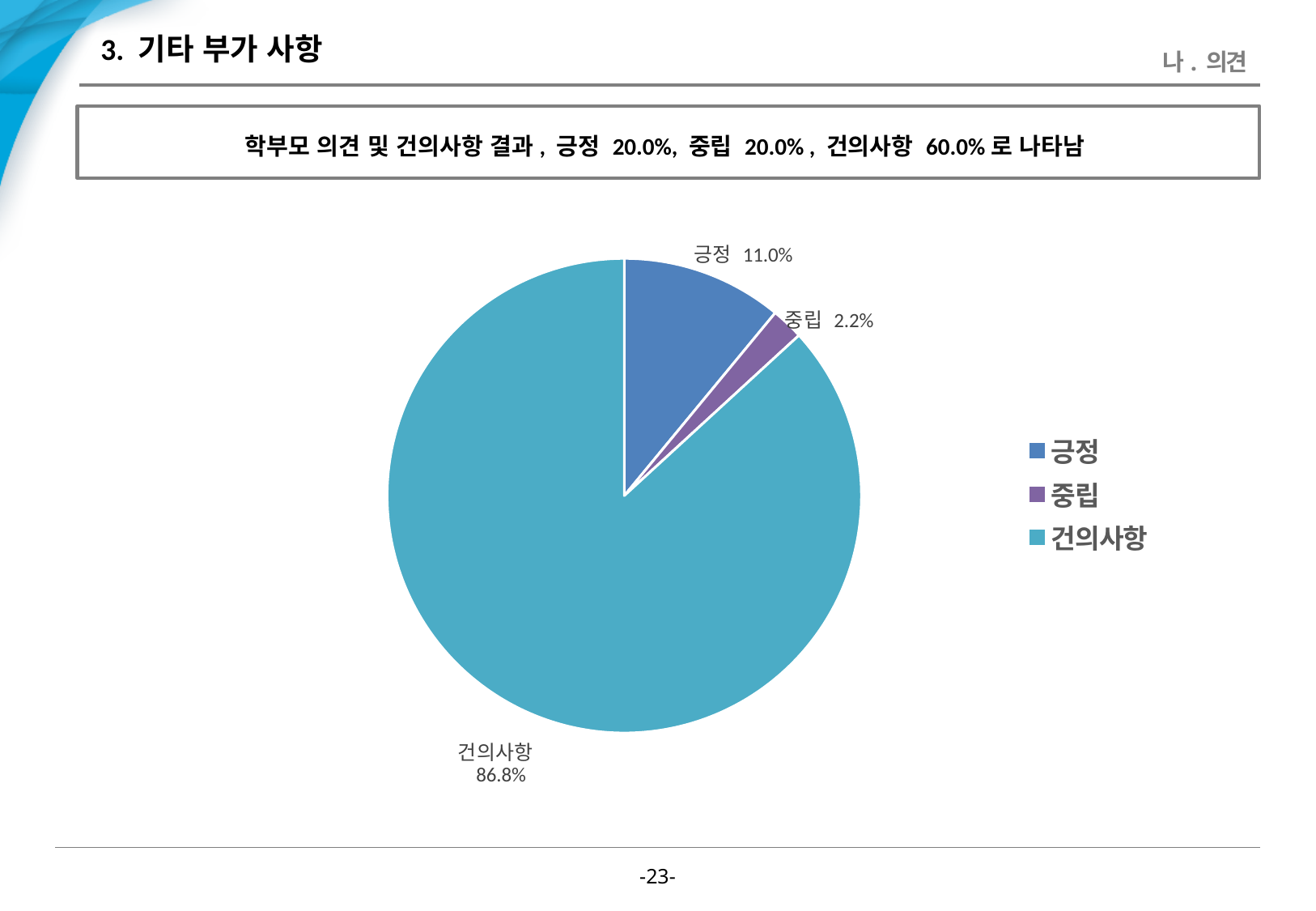
What colour is the 건의사항 slice in the pie chart? Teal (blue-green) What percentage does the 긍정 slice show in the pie chart? 11.0% What percentage does the 건의사항 slice show in the pie chart? 86.8% What is the difference in percentage points between the 긍정 slice and the 중립 slice? 8.8 How many slices does the pie chart have? 3 What type of chart is shown on the slide? Pie chart Which slice is larger, 긍정 or 중립? 긍정 Which category has the smallest slice in the pie chart? 중립 What percentage does the 중립 slice show in the pie chart? 2.2% How many entries does the legend list? 3 What is the difference in percentage points between the 건의사항 slice and the 긍정 slice? 75.8 Which category has the largest slice in the pie chart? 건의사항